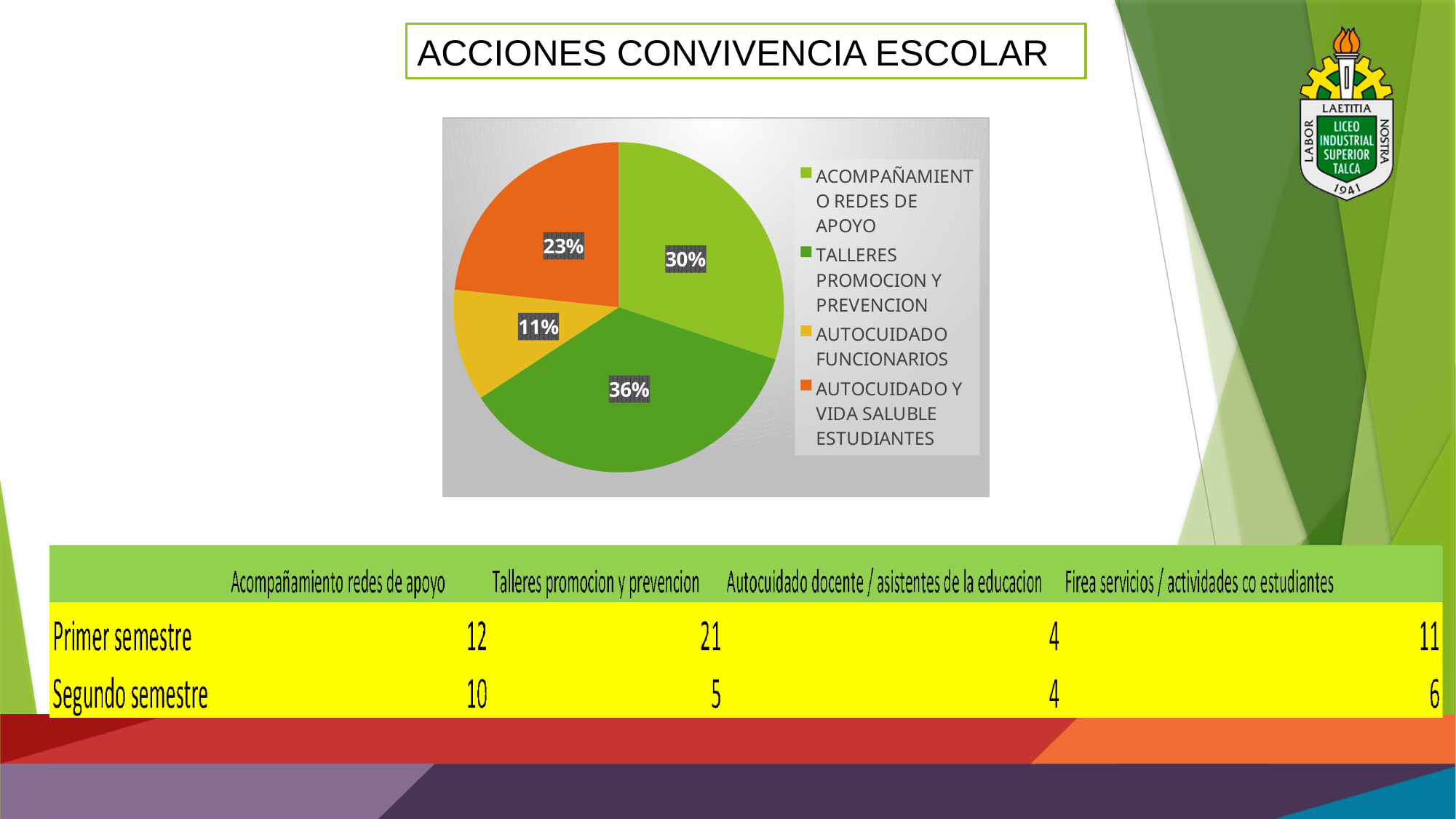
Which category has the smallest slice of the pie? AUTOCUIDADO FUNCIONARIOS What share of the pie does TALLERES PROMOCION Y PREVENCION represent? 36% What is the title shown above the pie chart on the slide? ACCIONES CONVIVENCIA ESCOLAR Which is larger: the slice for ACOMPAÑAMIENTO REDES DE APOYO or the slice for AUTOCUIDADO Y VIDA SALUBLE ESTUDIANTES? ACOMPAÑAMIENTO REDES DE APOYO What share of the pie does AUTOCUIDADO Y VIDA SALUBLE ESTUDIANTES represent? 23% What colour is the slice for AUTOCUIDADO Y VIDA SALUBLE ESTUDIANTES? orange Which category has the largest slice of the pie? TALLERES PROMOCION Y PREVENCION What is the difference in percentage points between TALLERES PROMOCION Y PREVENCION and AUTOCUIDADO FUNCIONARIOS? 25 What share of the pie does AUTOCUIDADO FUNCIONARIOS represent? 11% How many slices does the pie chart have? 4 What type of chart is shown on the slide? pie chart